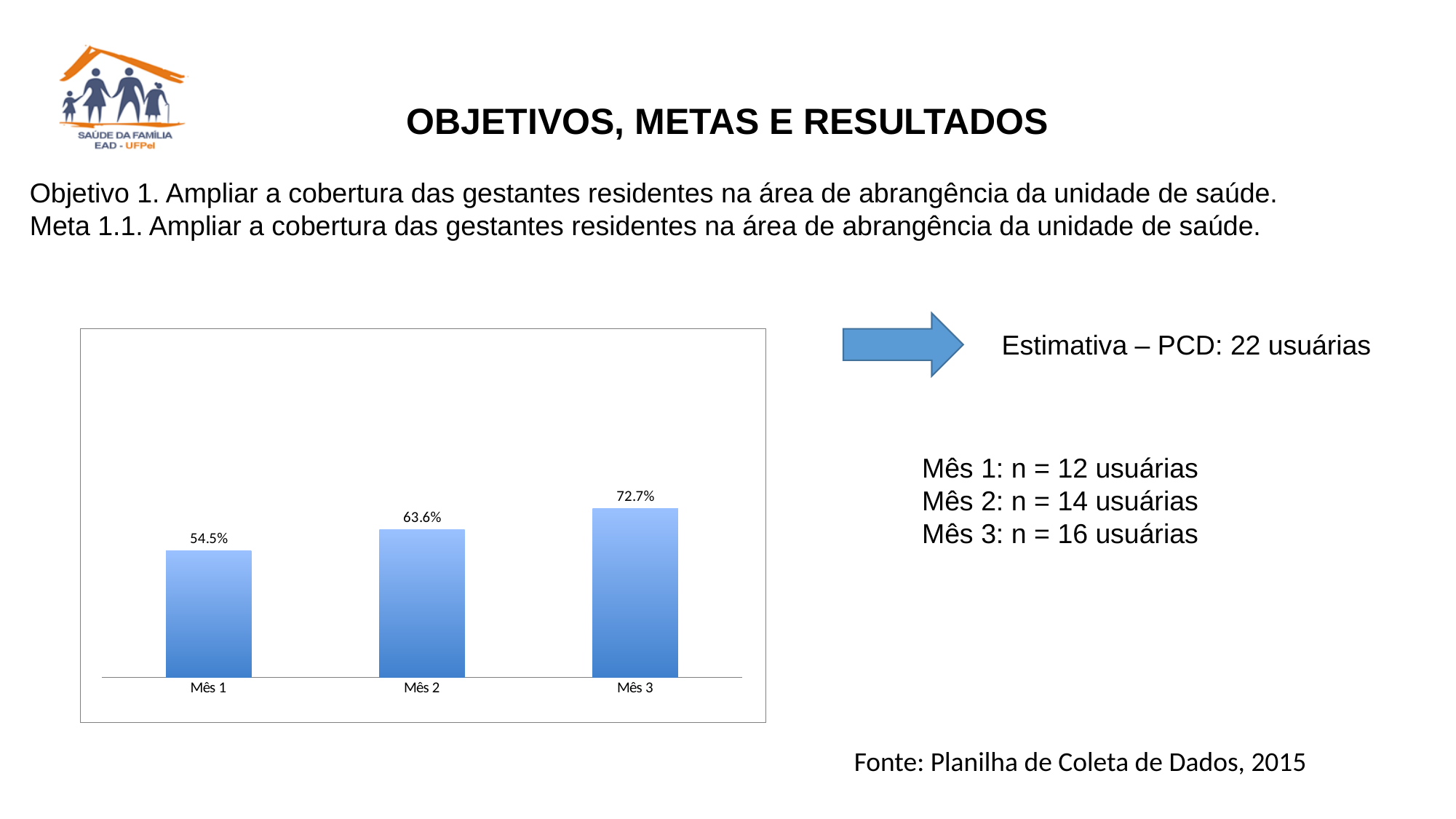
Which month has the lowest value? Mês 1 Which is larger, the value for Mês 2 or the value for Mês 3? Mês 3 How many months are shown on the chart? 3 Do the values rise or fall from Mês 1 to Mês 3? Rise What colour are the bars in the chart? Blue What is the difference between the values for Mês 2 and Mês 1? 9.1% What is the difference between the values for Mês 3 and Mês 1? 18.2% What is the value shown for Mês 1? 54.5% What is the value shown for Mês 2? 63.6% What kind of chart is shown on the slide? Bar chart Which month has the highest value? Mês 3 What is the value shown for Mês 3? 72.7%